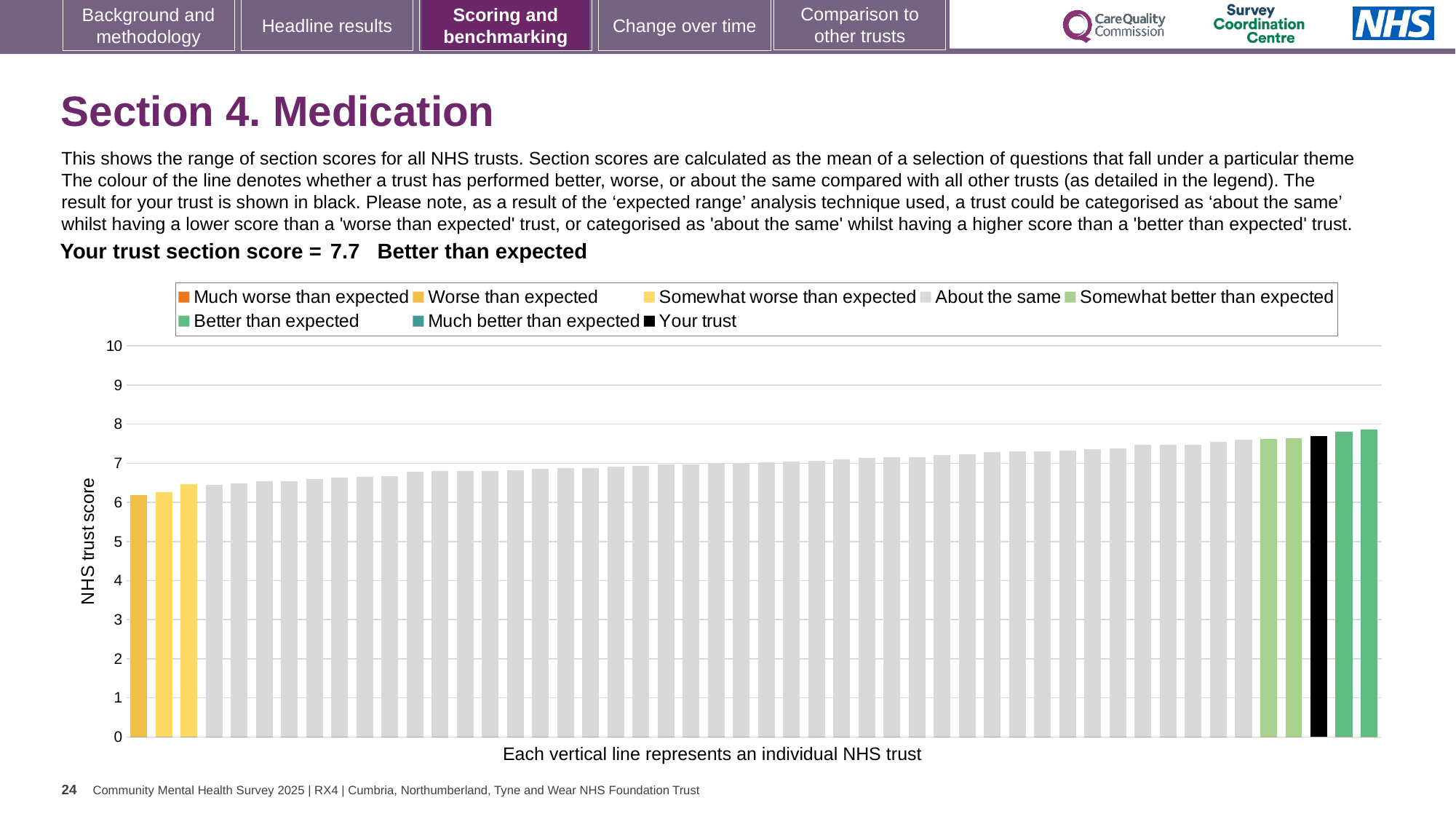
Do the bar values rise or fall from left to right along the x axis? rise Is the value for your trust (the black bar) greater or less than 7? greater How many bars are coloured yellow (worse than expected categories)? 3 Which is larger, the leftmost bar or the rightmost bar? the rightmost bar Is the value of the highest bar greater or less than 9? less Which bar is the highest on the chart? the rightmost bar What is the label on the y axis? NHS trust score What colour is the bar representing your trust? black Is the value of the leftmost bar greater or less than 7? less How many entries does the chart legend list? 8 What kind of chart is shown on the slide? bar chart What is your trust's section score for Medication? 7.7